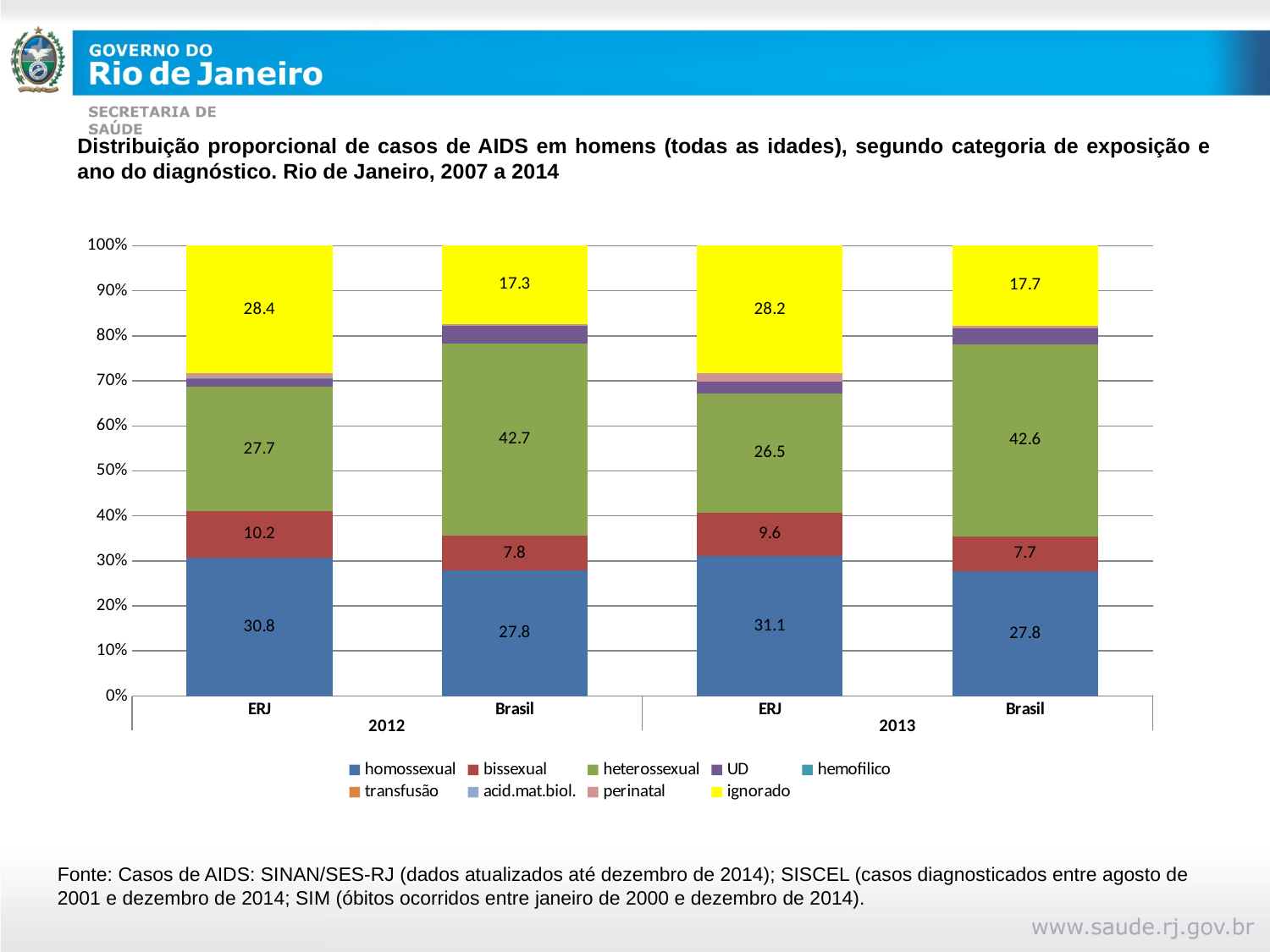
What is the value for homossexual in the ERJ 2012 bar? 30.8 Which is larger, the homossexual value for ERJ 2013 or for Brasil 2013? ERJ 2013 How many series does the legend list? 9 How many bars are plotted in the chart? 4 Which bar has the lowest value for bissexual? Brasil 2013 Which series is shown in yellow in the legend? ignorado Which bar has the highest value for heterossexual? Brasil 2012 What kind of chart is shown on the slide? stacked bar chart What is the difference between the ignorado values for ERJ 2012 and Brasil 2012? 11.1 What is the value for heterossexual in the Brasil 2012 bar? 42.7 What is the value for bissexual in the Brasil 2013 bar? 7.7 What is the value for ignorado in the ERJ 2013 bar? 28.2